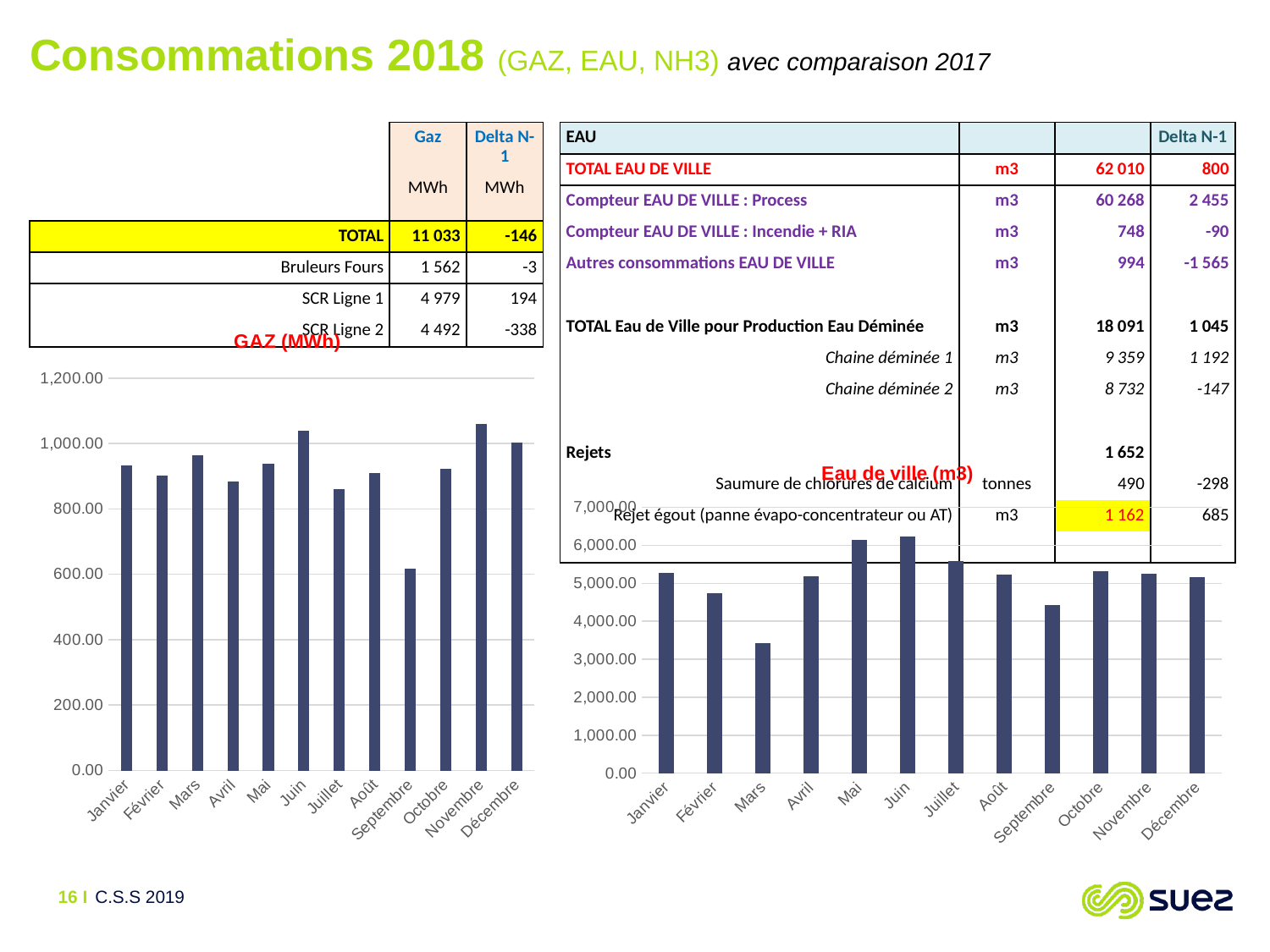
What kind of chart is the GAZ (MWh) chart on the left? bar chart In the GAZ (MWh) chart, which month has the lowest value? Septembre What kind of chart is the Eau de ville (m3) chart on the right? bar chart In the GAZ (MWh) chart, which month has the highest value? Novembre In the Eau de ville (m3) chart, is the value for Mars greater or less than 4,000? less In the Eau de ville (m3) chart, which month has the lowest value? Mars In the Eau de ville (m3) chart, which is larger, the value for Février or the value for Mars? Février In the GAZ (MWh) chart, how many months are plotted along the x axis? 12 In the GAZ (MWh) chart, is the value for Septembre greater or less than 800? less In the GAZ (MWh) chart, is the value for Juin greater or less than 1,000? greater In the Eau de ville (m3) chart, how many categories are shown on the x axis? 12